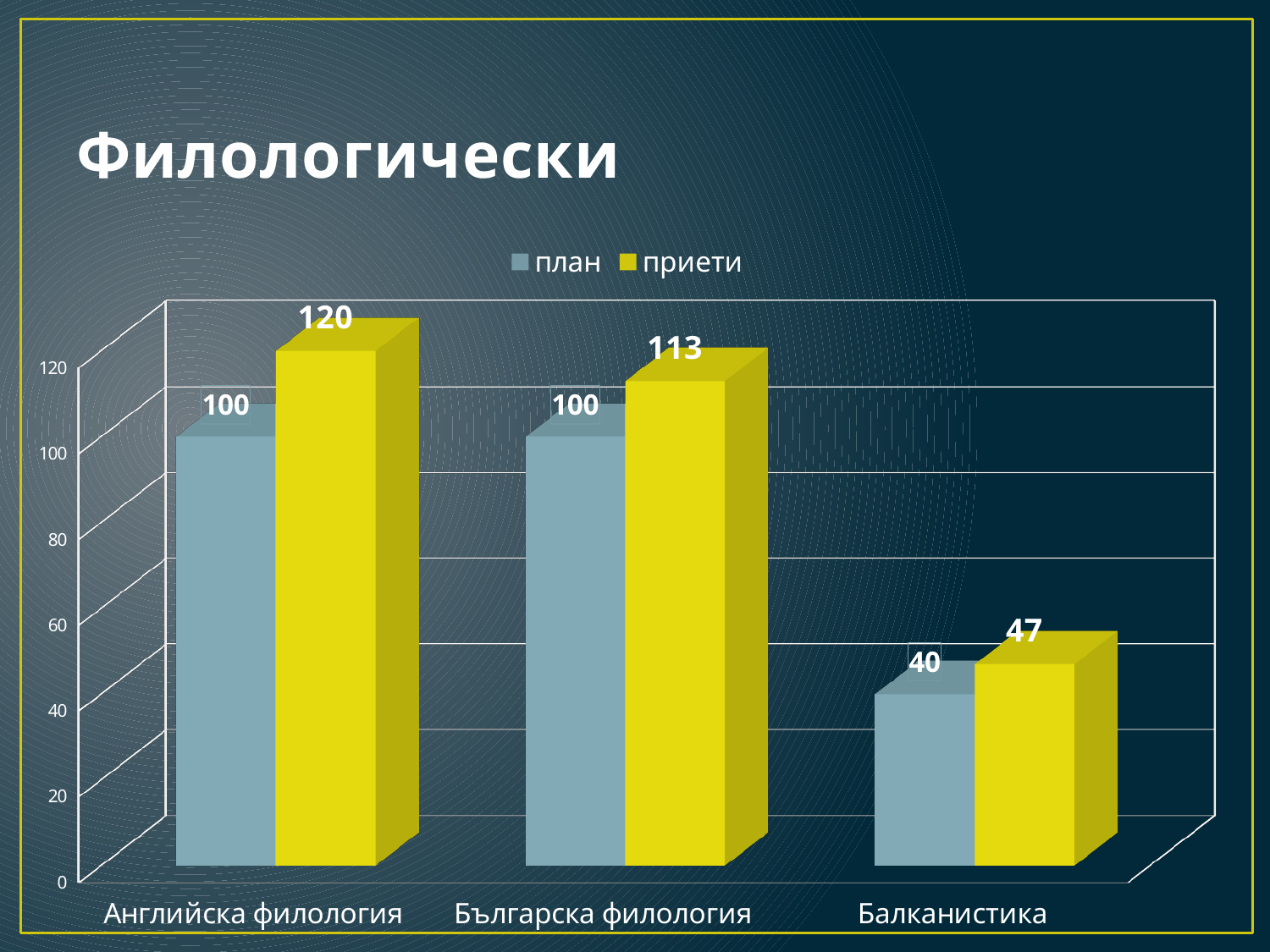
What is the difference between "приети" and "план" for Английска филология? 20 What is the title of the slide? Филологически Which category has the highest "приети" value? Английска филология Which category has the lowest "план" value? Балканистика What is the value of "план" for Балканистика? 40 How many series does the legend list? 2 How many categories are shown on the x axis? 3 What is the value of "приети" for Английска филология? 120 What is the difference between "приети" and "план" for Балканистика? 7 Which is larger for Българска филология: "план" or "приети"? приети What is the value of "приети" for Българска филология? 113 What kind of chart is shown on the slide? bar chart